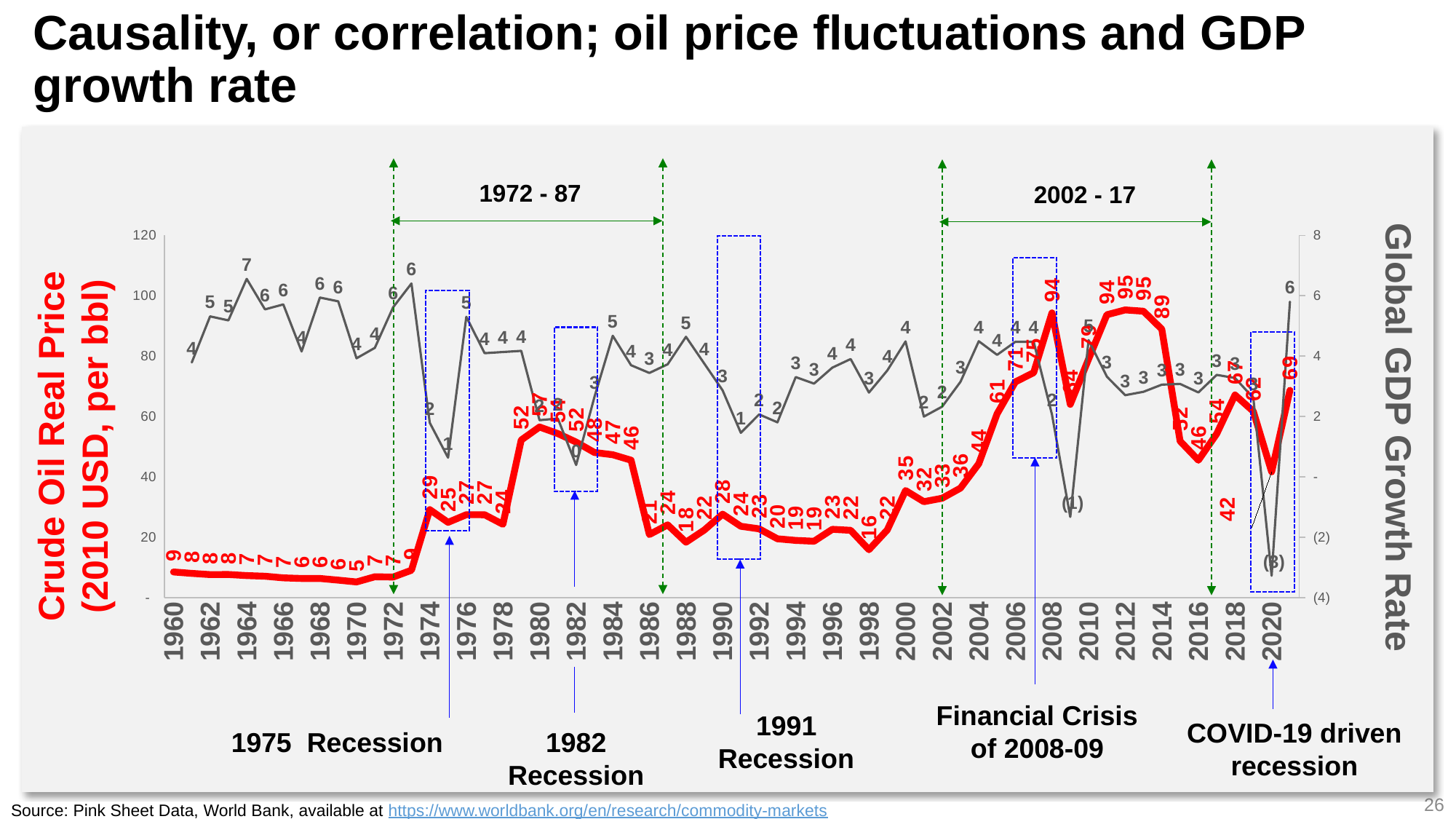
What is the global GDP growth rate in 2021? 6 Is the crude oil real price in 2012 greater or less than 80? greater Does the crude oil real price rise or fall from 2002 to 2008? rise What is the global GDP growth rate in 2020? (3) Which year has the higher crude oil real price, 1974 or 1975? 1974 What is the crude oil real price in 1980? 57 What is the label of the left vertical axis? Crude Oil Real Price (2010 USD, per bbl) What is the crude oil real price in 2008? 94 What is the difference between the crude oil real price in 2008 and in 2009? 30 What is the highest crude oil real price labelled on the chart? 95 What is the highest global GDP growth rate labelled on the chart? 7 What kind of chart is shown on the slide? line chart